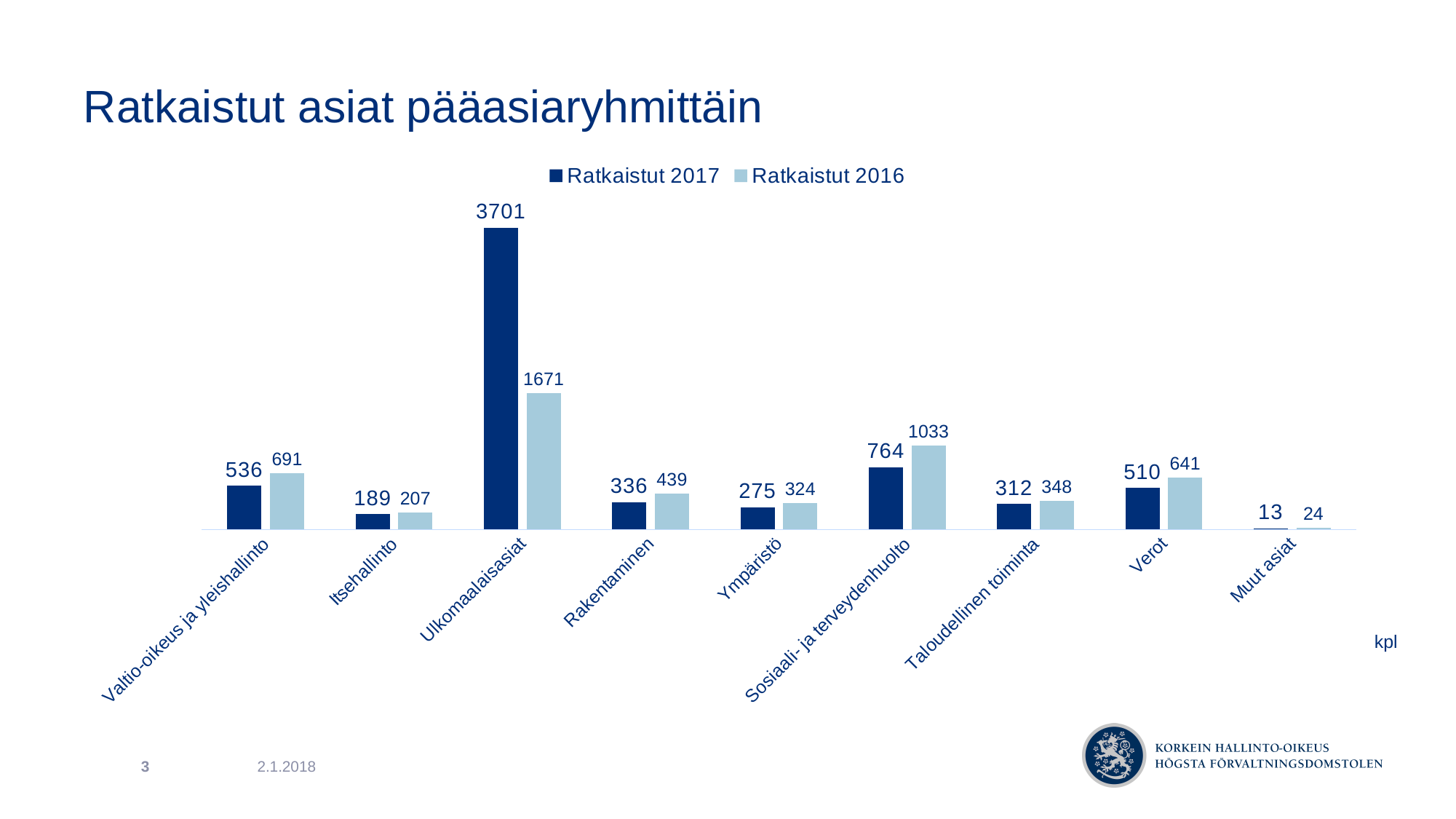
What is the Ratkaistut 2016 value for Sosiaali- ja terveydenhuolto? 1033 How many categories are shown on the x axis? 9 What is the title of the chart on the slide? Ratkaistut asiat pääasiaryhmittäin Which category has the highest Ratkaistut 2017 value? Ulkomaalaisasiat How many series does the legend list? 2 What kind of chart is shown on the slide? Bar chart What is the Ratkaistut 2017 value for Verot? 510 Which category has the lowest Ratkaistut 2016 value? Muut asiat What is the difference between the Ratkaistut 2016 and Ratkaistut 2017 values for Valtio-oikeus ja yleishallinto? 155 Which is larger for Rakentaminen: the Ratkaistut 2017 value or the Ratkaistut 2016 value? Ratkaistut 2016 What is the Ratkaistut 2017 value for Ulkomaalaisasiat? 3701 What is the difference between the Ratkaistut 2017 and Ratkaistut 2016 values for Ulkomaalaisasiat? 2030